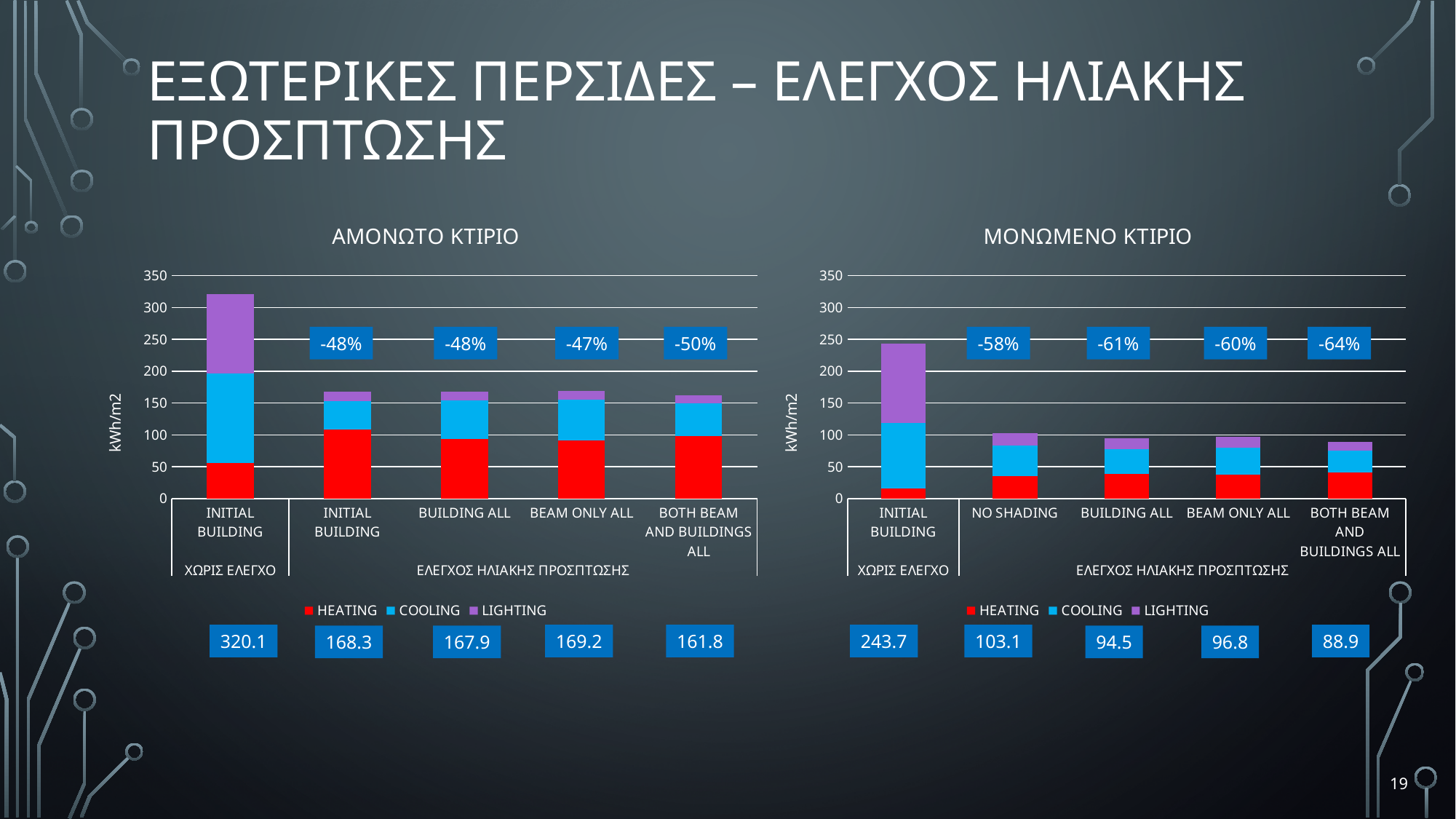
In the ΑΜΟΝΩΤΟ ΚΤΙΡΙΟ chart, which has the larger total shown: BEAM ONLY ALL or BUILDING ALL? BEAM ONLY ALL In the ΜΟΝΩΜΕΝΟ ΚΤΙΡΙΟ chart, which category has the highest total? INITIAL BUILDING What kind of chart is the ΑΜΟΝΩΤΟ ΚΤΙΡΙΟ chart on the left? Stacked bar chart In the ΑΜΟΝΩΤΟ ΚΤΙΡΙΟ chart, is the HEATING segment of the INITIAL BUILDING bar under ΧΩΡΙΣ ΕΛΕΓΧΟ greater or less than 100? less In the ΑΜΟΝΩΤΟ ΚΤΙΡΙΟ chart, which category has the lowest total value shown? BOTH BEAM AND BUILDINGS ALL What is the label on the vertical axis of the ΜΟΝΩΜΕΝΟ ΚΤΙΡΙΟ chart? kWh/m2 How many bars are plotted in the ΑΜΟΝΩΤΟ ΚΤΙΡΙΟ chart? 5 In the ΜΟΝΩΜΕΝΟ ΚΤΙΡΙΟ chart, what total value is shown below the BOTH BEAM AND BUILDINGS ALL bar? 88.9 In the ΜΟΝΩΜΕΝΟ ΚΤΙΡΙΟ chart, what percentage change is shown above the BUILDING ALL bar? -61% In the ΑΜΟΝΩΤΟ ΚΤΙΡΙΟ chart, what is the difference between the total for INITIAL BUILDING under ΧΩΡΙΣ ΕΛΕΓΧΟ (320.1) and the total for BOTH BEAM AND BUILDINGS ALL (161.8)? 158.3 In the ΑΜΟΝΩΤΟ ΚΤΙΡΙΟ chart, what total value is shown below the INITIAL BUILDING bar under ΧΩΡΙΣ ΕΛΕΓΧΟ? 320.1 How many series does the legend of the ΜΟΝΩΜΕΝΟ ΚΤΙΡΙΟ chart list? 3